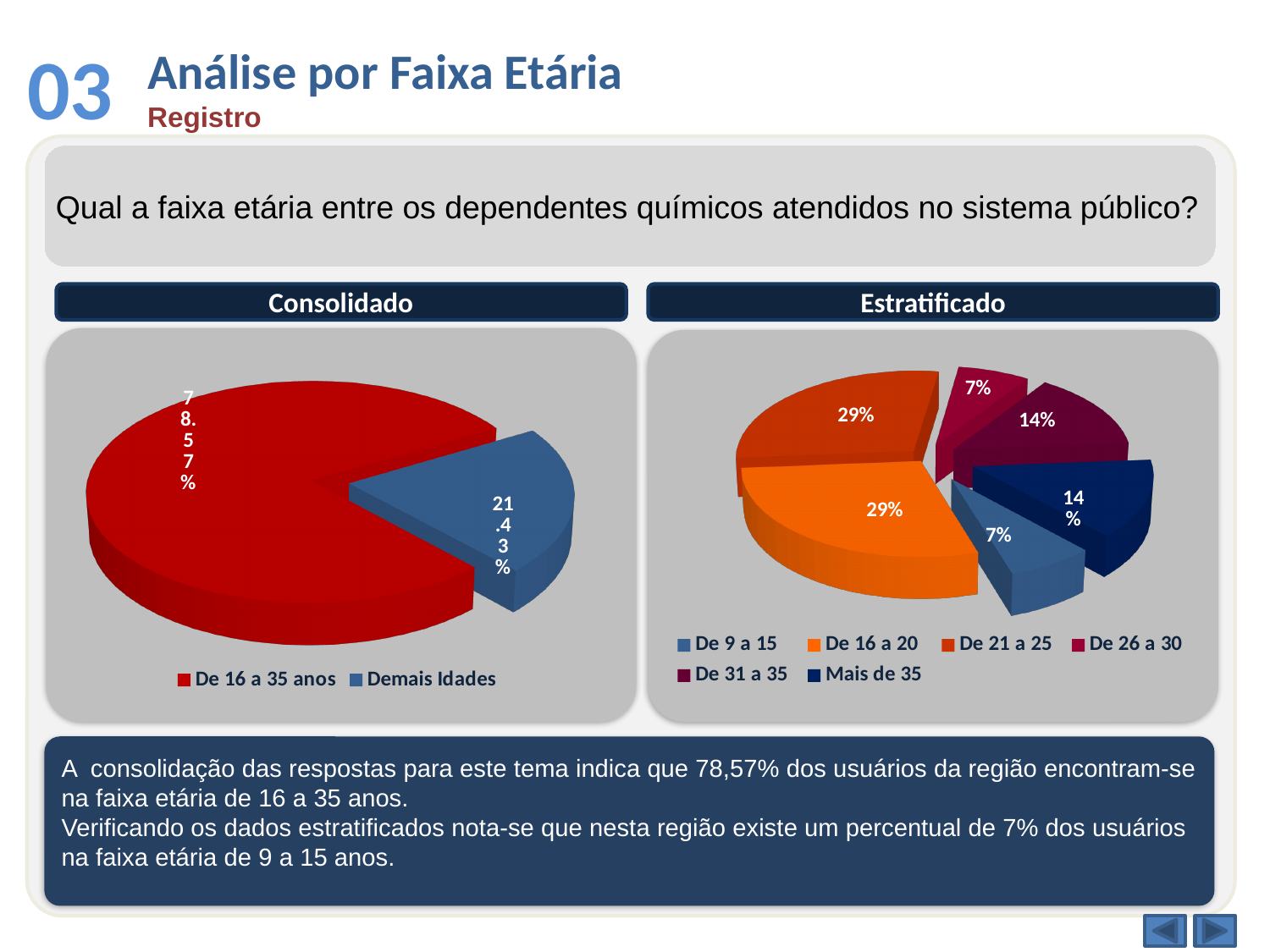
In the Estratificado chart, what percentage is shown for De 31 a 35? 14% In the Consolidado chart, what percentage is shown for De 16 a 35 anos? 78.57% How many categories does the legend of the Estratificado chart list? 6 In the Estratificado chart, what percentage is shown for De 16 a 20? 29% In the Estratificado chart, what percentage is shown for De 9 a 15? 7% What kind of chart is the Consolidado chart? Pie chart In the Consolidado chart, what is the difference between the De 16 a 35 anos slice and the Demais Idades slice? 57.14% In the Consolidado chart, which category has the largest slice? De 16 a 35 anos How many categories does the legend of the Consolidado chart list? 2 In the Estratificado chart, what is the combined share of De 16 a 20 and De 21 a 25? 58% In the Estratificado chart, which is larger, the slice for De 31 a 35 or the slice for De 26 a 30? De 31 a 35 In the Consolidado chart, what percentage is shown for Demais Idades? 21.43%